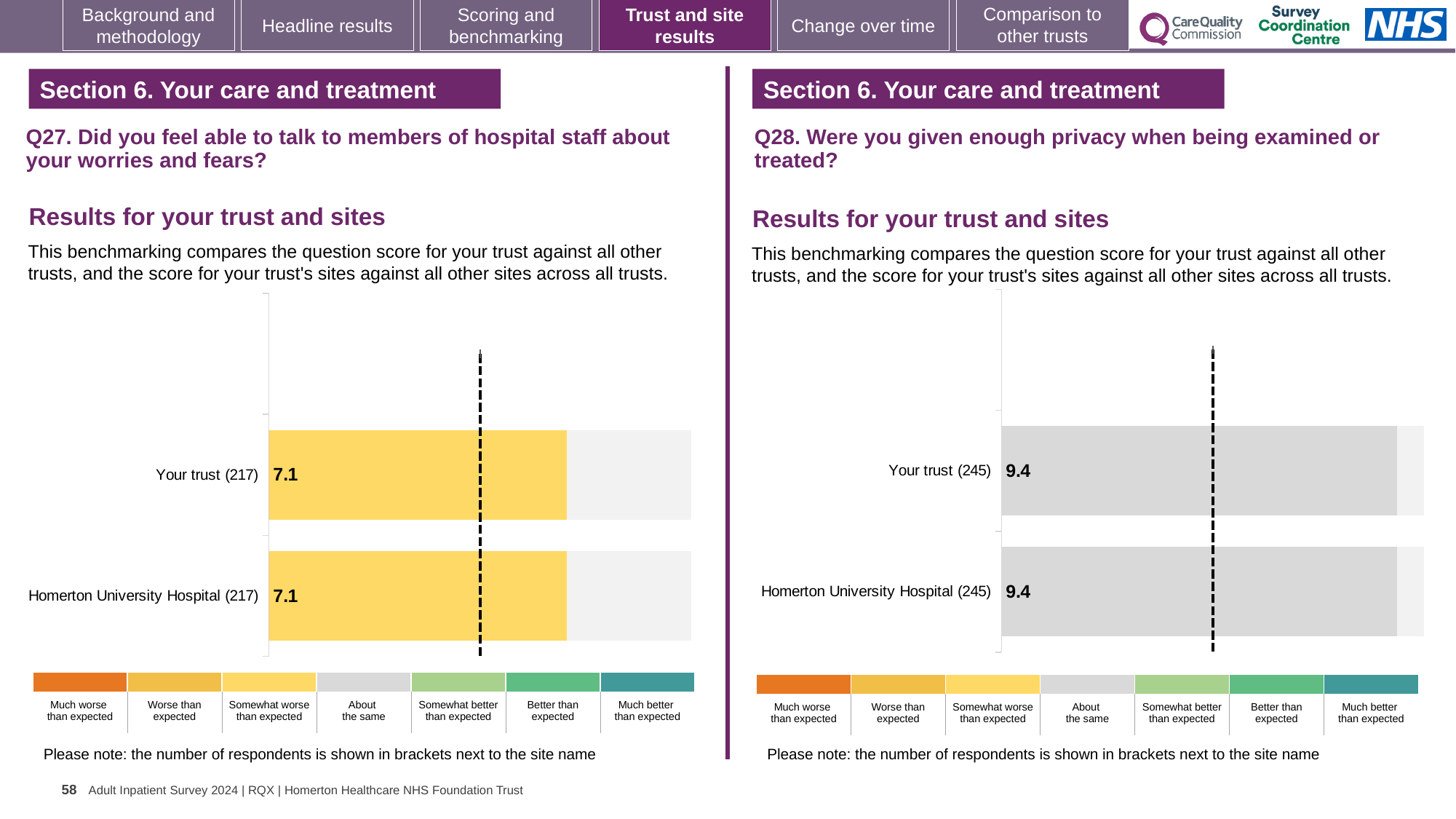
In the Q27 chart (left), what is the difference between the score for Your trust and the score for Homerton University Hospital? 0 In the Q27 chart (left), which benchmark category does the colour of the bars correspond to according to the legend? Somewhat worse than expected In the Q28 chart (right), which benchmark category does the colour of the bars correspond to according to the legend? About the same In the Q28 chart (right), what is the score for Your trust? 9.4 In the Q27 chart (left), what is the score for Your trust? 7.1 In the Q27 chart (left), what is the score for Homerton University Hospital? 7.1 In the Q28 chart (right), what is the score for Homerton University Hospital? 9.4 What kind of chart is used for the Q27 results on the left? Bar chart In the Q28 chart (right), how many respondents are shown in brackets for Homerton University Hospital? 245 In the Q27 chart (left), how many bars are plotted? 2 In the Q28 chart (right), how many bars are plotted? 2 In the Q27 chart (left), how many respondents are shown in brackets for Your trust? 217